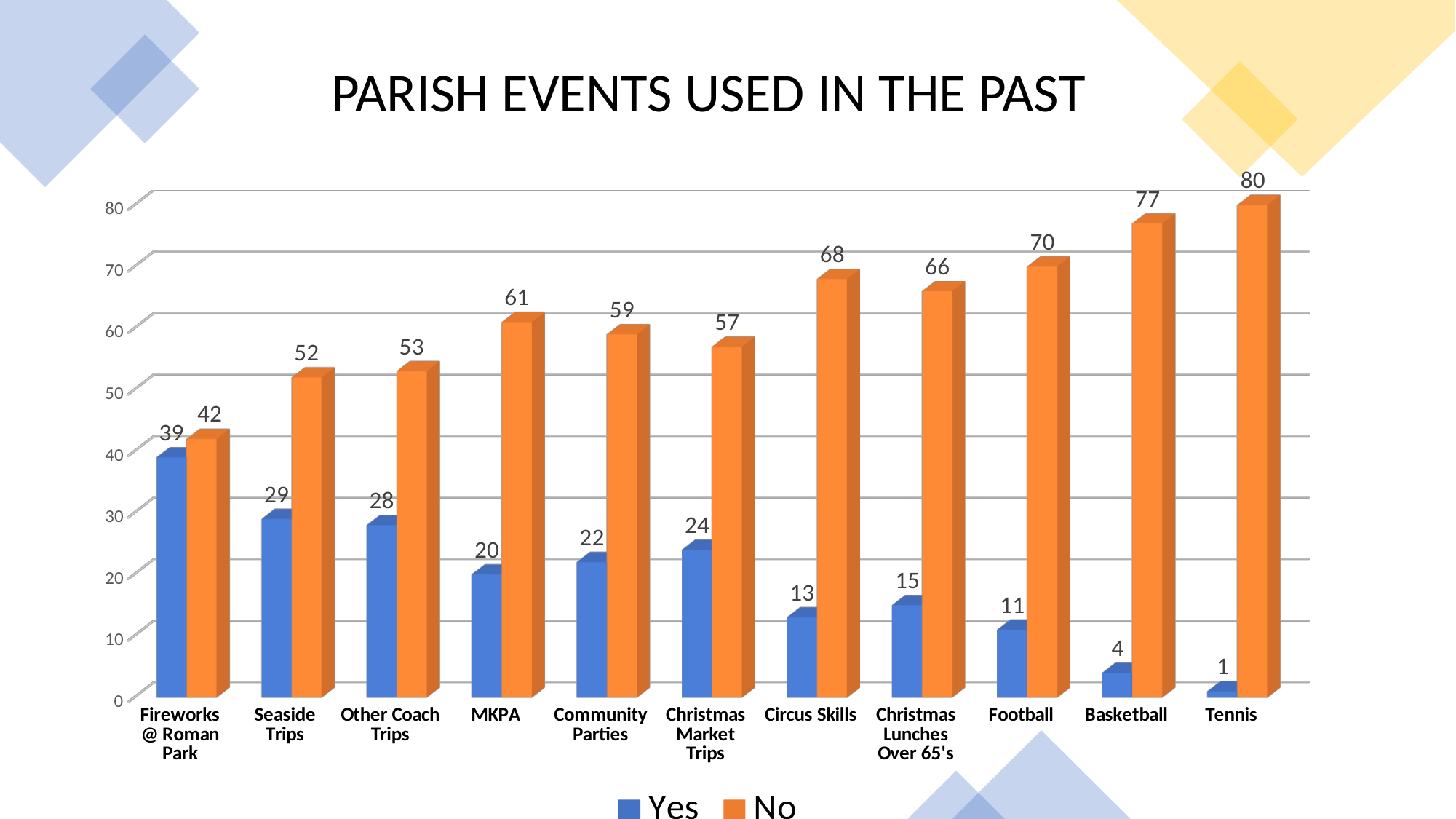
Which category has the highest 'No' value? Tennis Do the 'No' values generally rise or fall from left to right along the x axis? Rise What is the 'Yes' value for Fireworks @ Roman Park? 39 Which is larger: the 'Yes' value for Seaside Trips or the 'Yes' value for Circus Skills? Seaside Trips What is the title of the chart? PARISH EVENTS USED IN THE PAST Which category has the lowest 'Yes' value? Tennis How many categories are shown on the x axis? 11 What is the difference between the 'No' and 'Yes' values for MKPA? 41 How many series does the legend list? 2 What kind of chart is shown on the slide? Bar chart What is the 'No' value for Tennis? 80 What is the 'Yes' value for Christmas Market Trips? 24